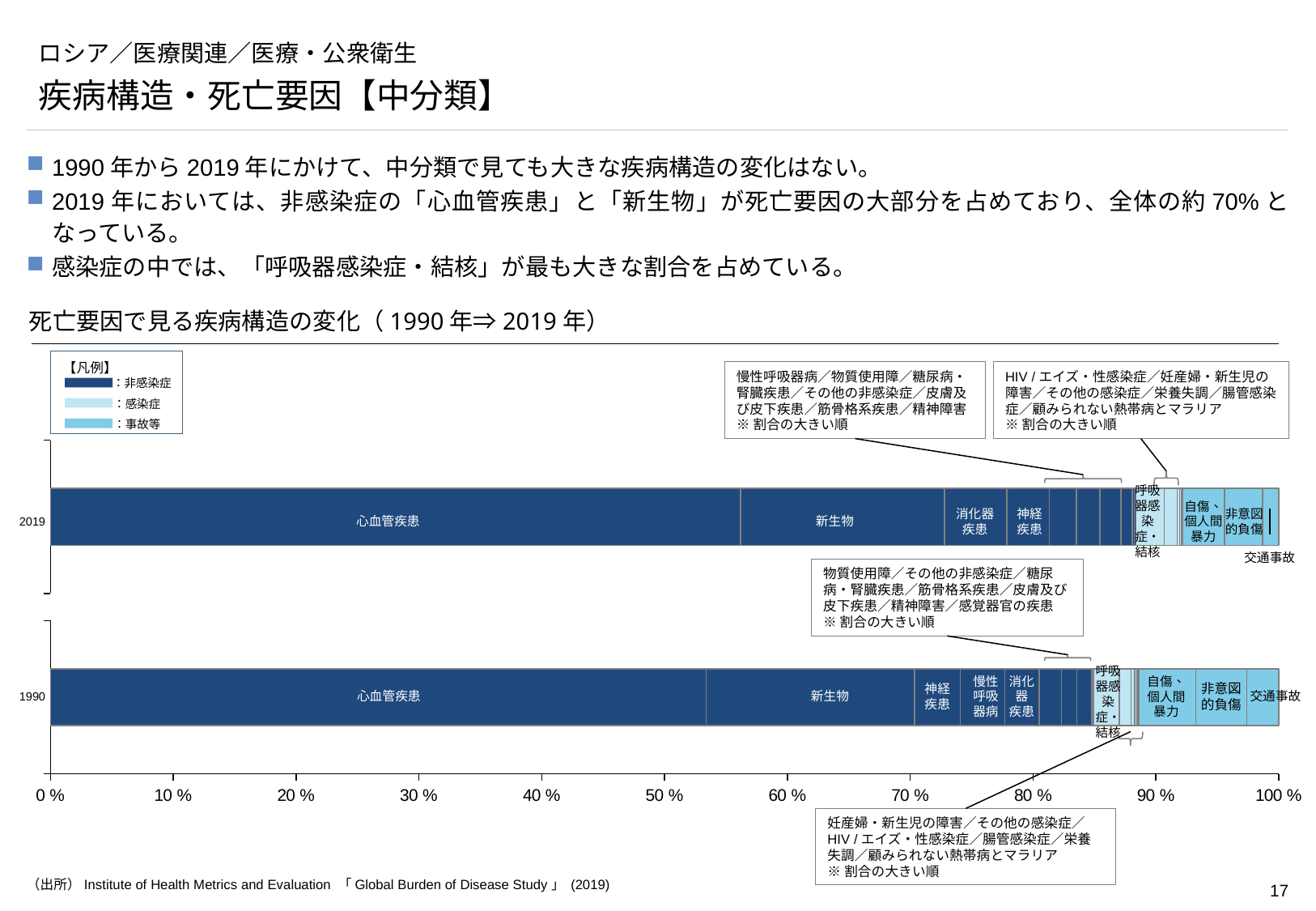
How many categories does the legend (凡例) list? 3 In the 2019 bar, which segment is larger: 心血管疾患 or 新生物? 心血管疾患 Which cause of death has the largest share in the 1990 bar? 心血管疾患 What kind of chart is shown on the slide? Stacked bar chart What is the title of the chart? 死亡要因で見る疾病構造の変化（1990年⇒2019年） Is the share of 心血管疾患 in 1990 greater or less than 40%? greater Is the share of 心血管疾患 in 2019 greater or less than 50%? greater Which cause of death has the largest share in the 2019 bar? 心血管疾患 In the 1990 bar, which segment is larger: 新生物 or 神経疾患? 新生物 Is the share of 新生物 in 2019 greater or less than 10%? greater How many years (bars) are plotted in the chart? 2 Which legend category is shown in dark navy blue? 非感染症